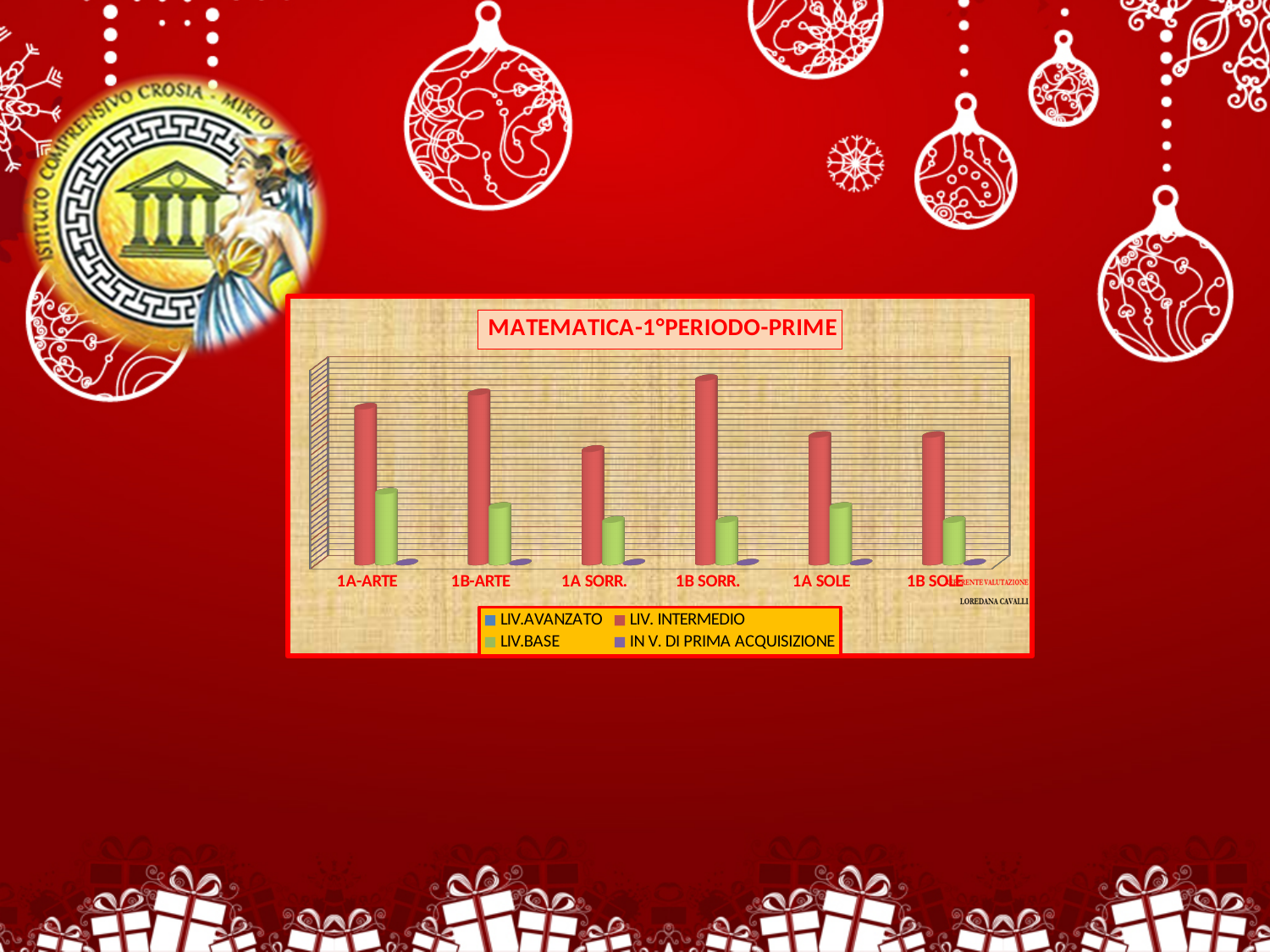
What type of chart is shown on the slide? bar chart Which class has the highest LIV.BASE bar? 1A-ARTE Which colour represents the LIV.BASE series in the chart legend? green Which class has the highest LIV. INTERMEDIO bar? 1B SORR. Which class has a higher LIV. INTERMEDIO bar, 1A-ARTE or 1B-ARTE? 1B-ARTE How many series does the chart legend list? 4 Which class has a higher LIV. INTERMEDIO bar, 1B SORR. or 1A SORR.? 1B SORR. Within the 1B SORR. class, which series has the taller bar, LIV. INTERMEDIO or LIV.BASE? LIV. INTERMEDIO What is the title of the chart? MATEMATICA-1°PERIODO-PRIME How many categories (classes) are shown on the x axis of the chart? 6